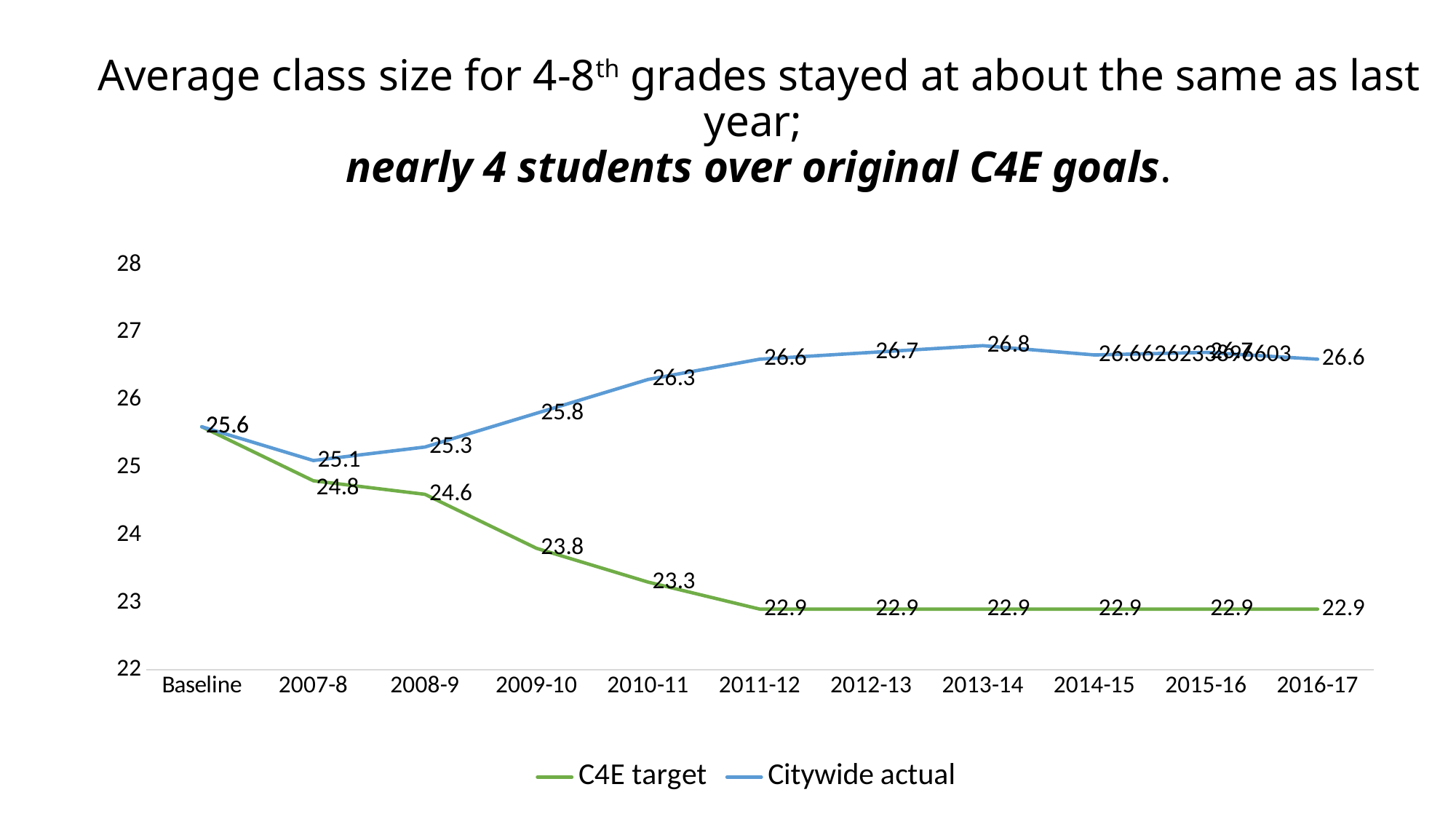
What type of chart is shown on the slide? line chart How many categories are shown on the x axis? 11 Does the C4E target series rise or fall from Baseline to 2011-12? fall What is the difference between the Citywide actual and C4E target values in 2016-17? 3.7 What is the C4E target value for 2009-10? 23.8 In which year is the Citywide actual value lowest? 2007-8 What is the Citywide actual value for 2016-17? 26.6 Which is larger in 2008-9, the C4E target or the Citywide actual? Citywide actual How many series does the legend list? 2 In which year does the Citywide actual series reach its highest value? 2013-14 What is the Citywide actual value for 2010-11? 26.3 Which series is drawn in green? C4E target